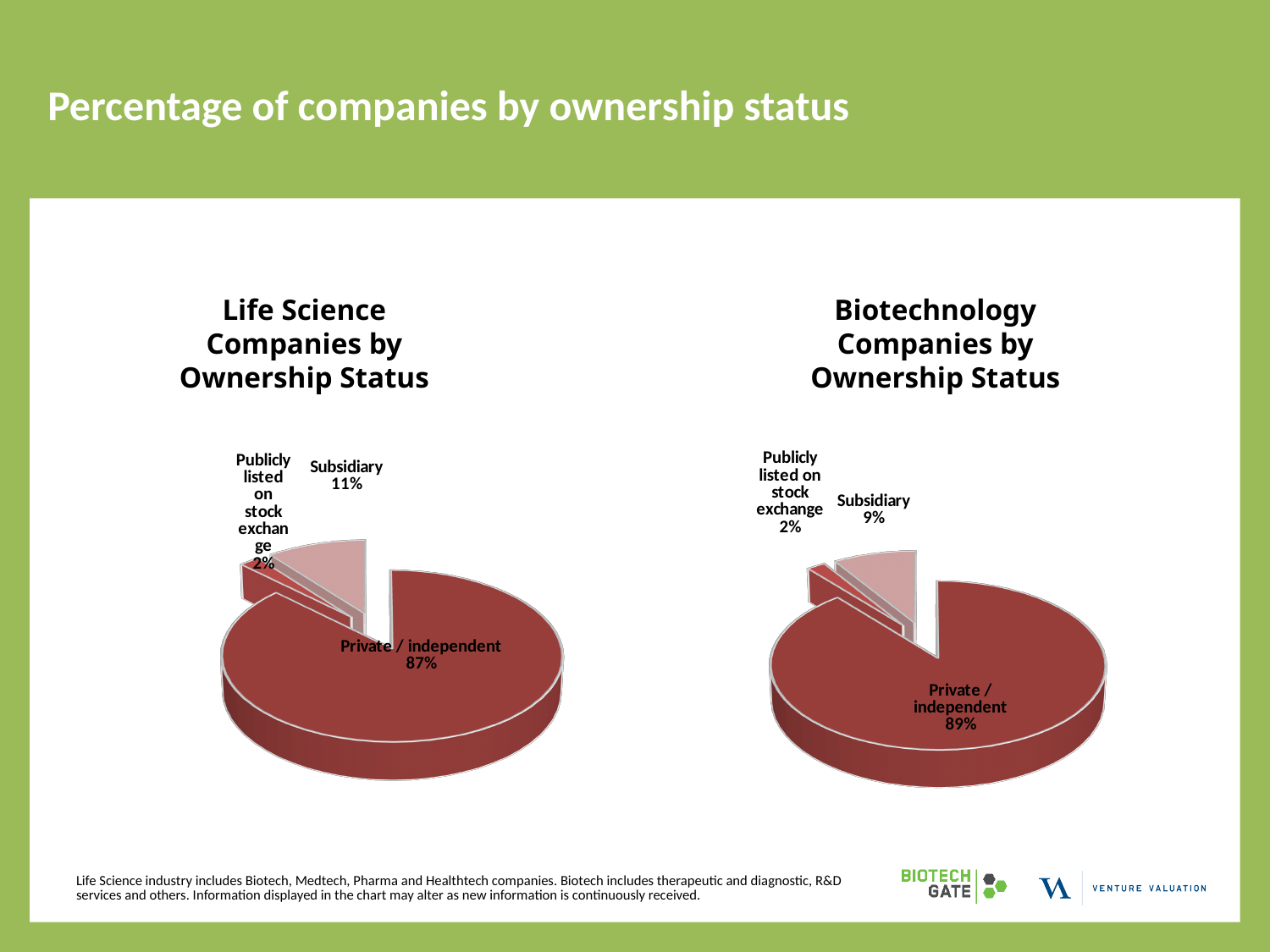
In the 'Biotechnology Companies by Ownership Status' chart, what percentage of companies are Private / independent? 89% Which chart shows a larger Subsidiary share, 'Life Science Companies by Ownership Status' or 'Biotechnology Companies by Ownership Status'? Life Science Companies by Ownership Status What type of chart is used for 'Life Science Companies by Ownership Status'? Pie chart In the 'Biotechnology Companies by Ownership Status' chart, what percentage of companies are Publicly listed on stock exchange? 2% How many slices does the 'Biotechnology Companies by Ownership Status' pie chart have? 3 What is the title of the slide? Percentage of companies by ownership status In the 'Biotechnology Companies by Ownership Status' chart, what is the combined share of Subsidiary and Publicly listed on stock exchange companies? 11% In the 'Life Science Companies by Ownership Status' chart, what is the difference between the Subsidiary share and the Publicly listed on stock exchange share? 9 percentage points In the 'Biotechnology Companies by Ownership Status' chart, which ownership status has the smallest share? Publicly listed on stock exchange In the 'Life Science Companies by Ownership Status' chart, which ownership status has the largest share? Private / independent In the 'Life Science Companies by Ownership Status' chart, what percentage of companies are Subsidiary? 11% In the 'Life Science Companies by Ownership Status' chart, what percentage of companies are Private / independent? 87%